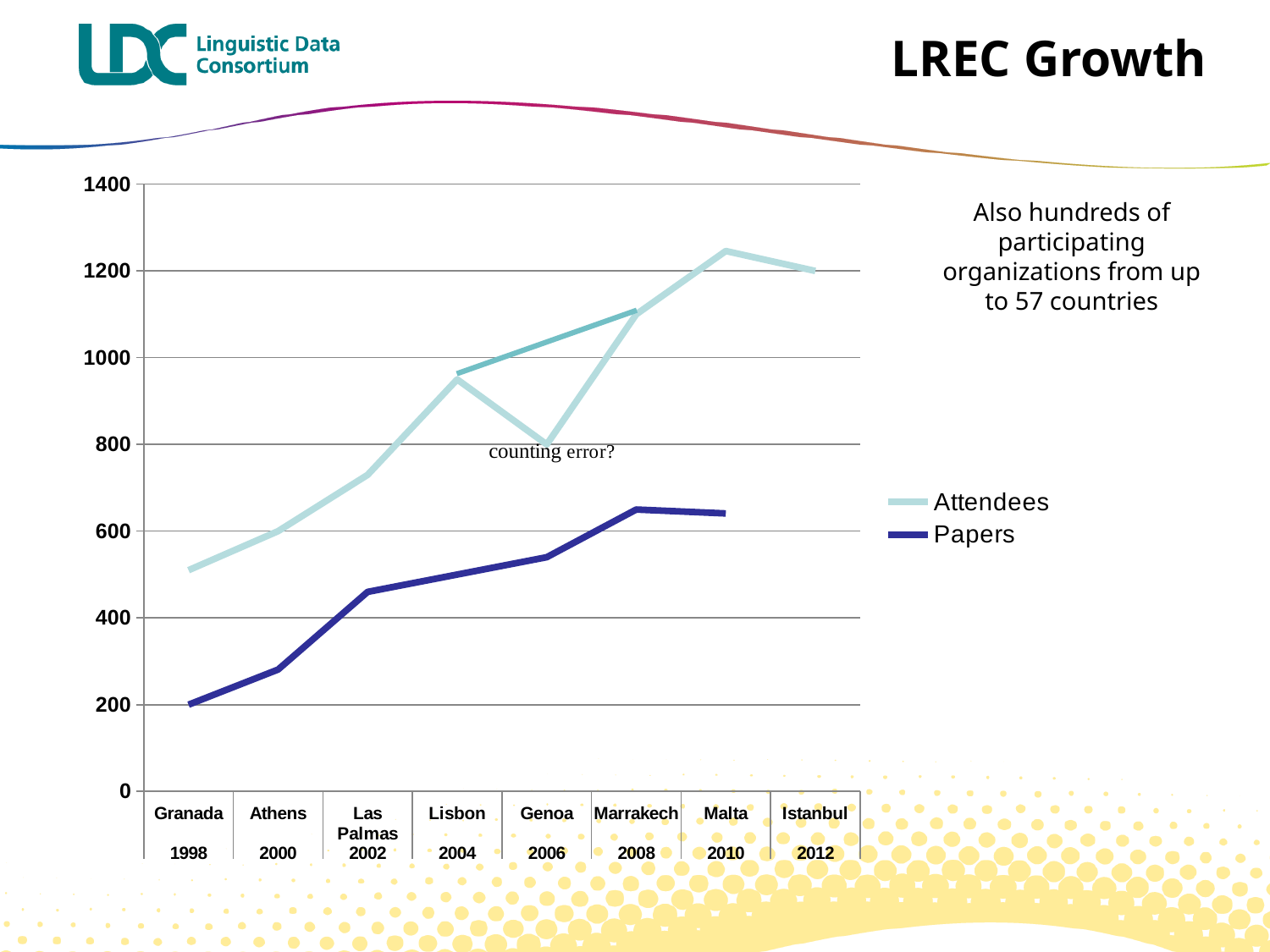
Which location has the lowest number of Papers? Granada Which location has the highest number of Attendees? Malta What kind of chart is shown on the slide? line chart Do the Papers values generally rise or fall from Granada to Marrakech? rise At Lisbon, which series has the larger value, Attendees or Papers? Attendees Which location has the lowest number of Attendees? Granada Is the Attendees value for Malta greater or less than 1200? greater How many series does the legend list? 2 Is the Attendees value for Granada greater or less than 600? less Is the Papers value for Athens greater or less than 400? less How many conference locations are shown along the x axis? 8